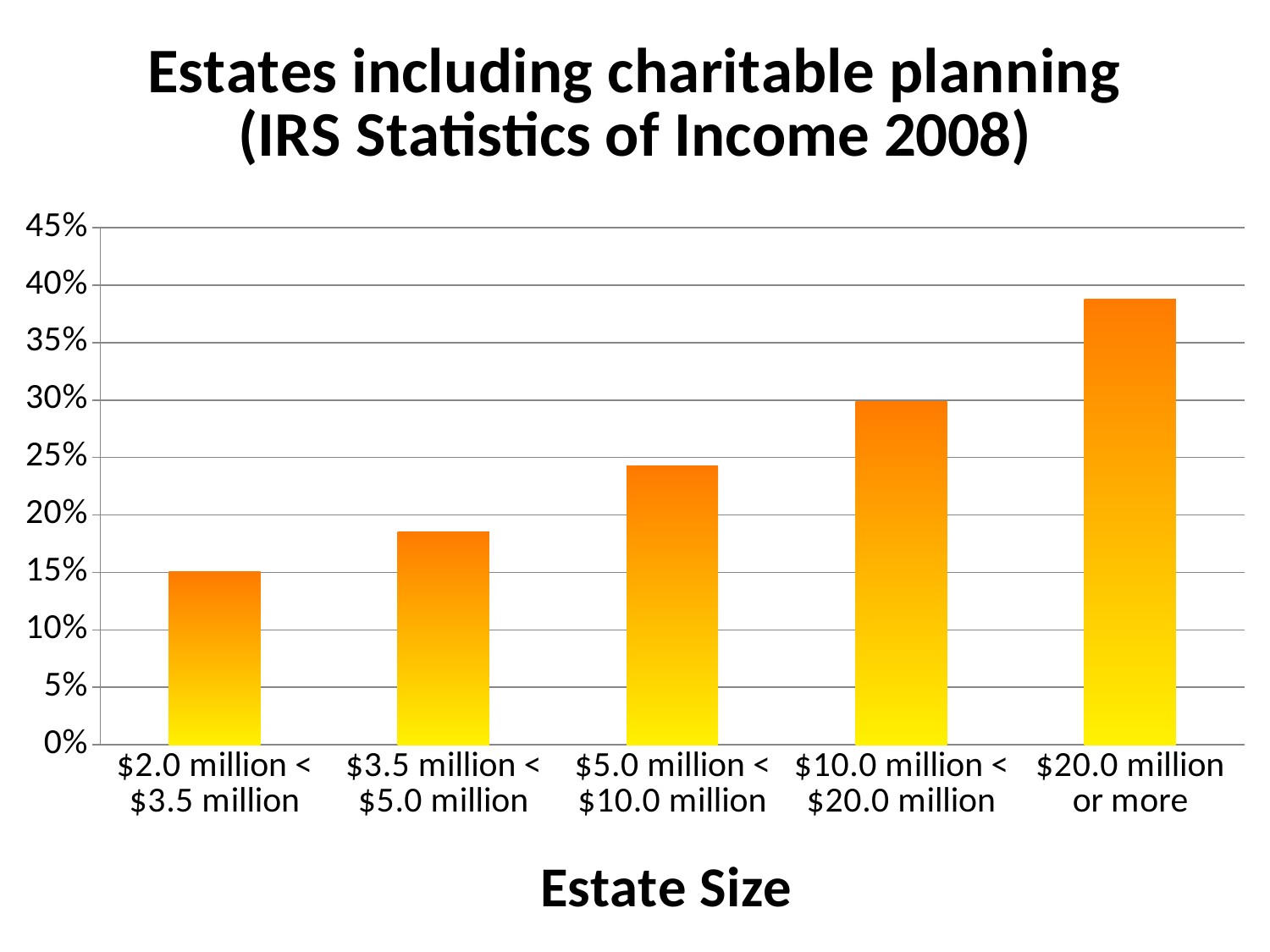
Is the value for $10.0 million < $20.0 million greater or less than 25%? greater Is the value for $5.0 million < $10.0 million greater or less than 20%? greater Is the value for $3.5 million < $5.0 million greater or less than 20%? less What kind of chart is shown on the slide? bar chart What is the label of the x axis? Estate Size Which estate size category has the lowest value? $2.0 million < $3.5 million Which estate size category has the highest value? $20.0 million or more Do the values rise or fall as estate size increases along the x axis? rise Which is larger, the value for $5.0 million < $10.0 million or the value for $3.5 million < $5.0 million? $5.0 million < $10.0 million What is the title of the chart? Estates including charitable planning (IRS Statistics of Income 2008) How many estate size categories are shown in the chart? 5